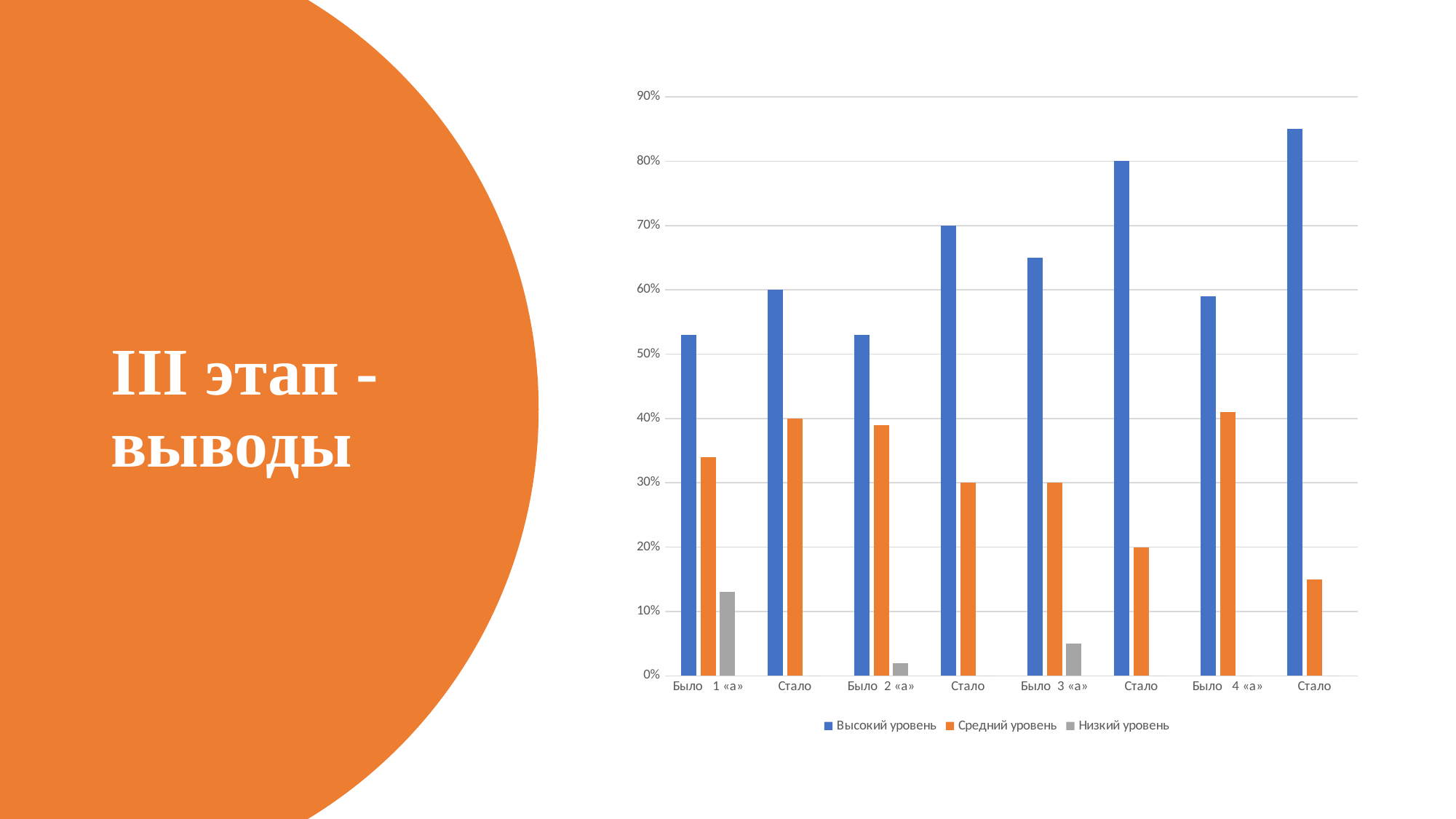
Which series is shown in grey in the legend? Низкий уровень What kind of chart is shown on the slide? bar chart What is the value of Высокий уровень for the Стало category following Было 2 «а»? 70% How many categories are shown along the x axis? 8 How many series does the legend list? 3 What is the value of Высокий уровень for the Стало category following Было 1 «а»? 60% Is the value of Низкий уровень for Было 3 «а» greater or less than 10%? less What is the value of Средний уровень for the Стало category following Было 1 «а»? 40% Which category has the highest Высокий уровень bar? Стало (after Было 4 «а») Which is larger: Средний уровень for Было 4 «а» or Средний уровень for the Стало category that follows it? Было 4 «а» Is the value of Высокий уровень for Было 1 «а» greater or less than 50%? greater What is the value of Высокий уровень for the Стало category following Было 3 «а»? 80%